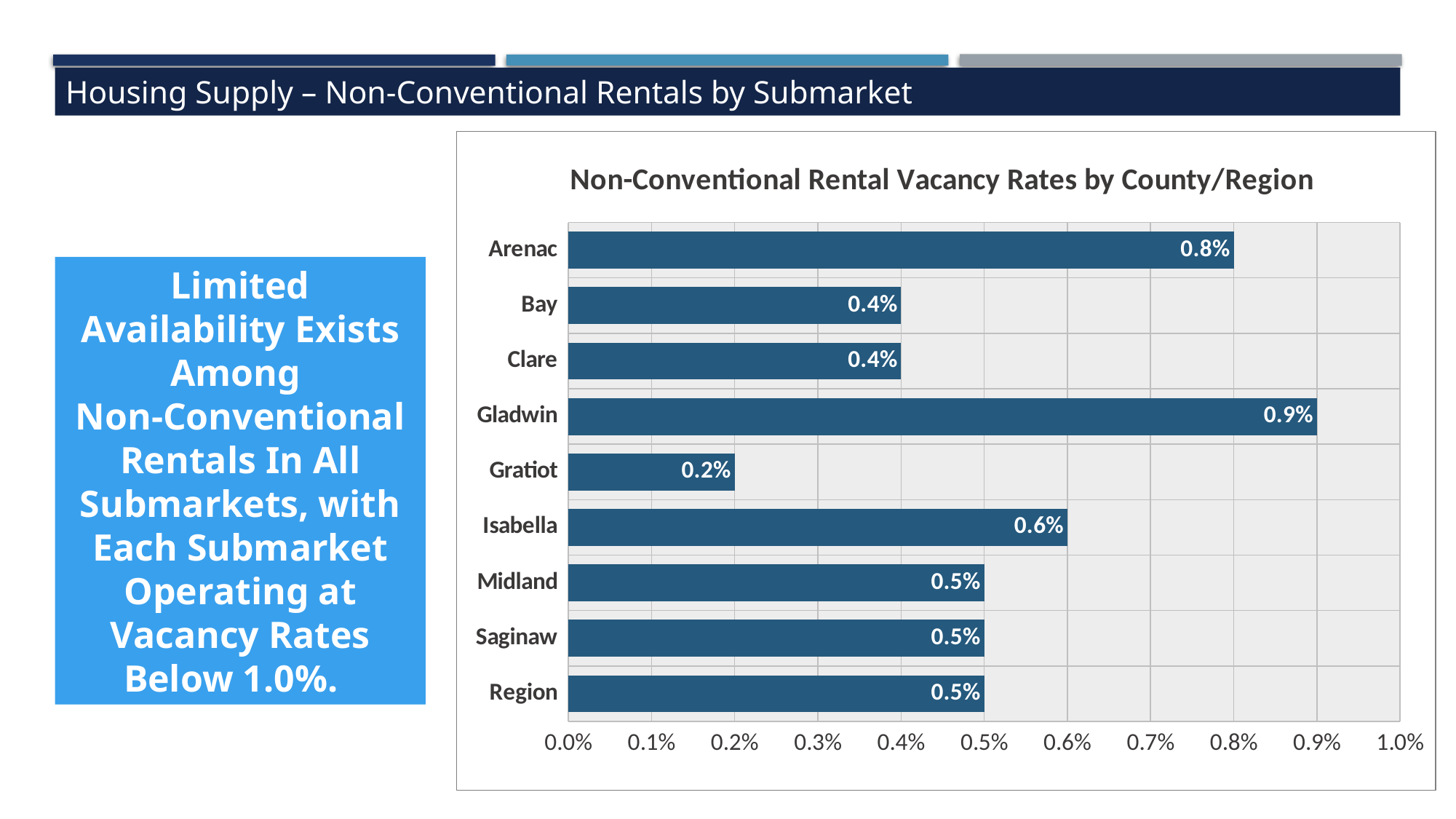
Is the vacancy rate for Gladwin greater or less than 0.5%? greater Which has a higher vacancy rate, Arenac or Isabella? Arenac What is the non-conventional rental vacancy rate for Gratiot? 0.2% What is the title of the chart? Non-Conventional Rental Vacancy Rates by County/Region How many counties/regions are shown in the chart? 9 Which county/region has the highest non-conventional rental vacancy rate? Gladwin What is the non-conventional rental vacancy rate for Arenac? 0.8% What kind of chart is shown on the slide? Bar chart Which county/region has the lowest non-conventional rental vacancy rate? Gratiot What is the non-conventional rental vacancy rate for the Region? 0.5% What is the non-conventional rental vacancy rate for Isabella? 0.6% What is the difference between the vacancy rates of Gladwin and Gratiot? 0.7%